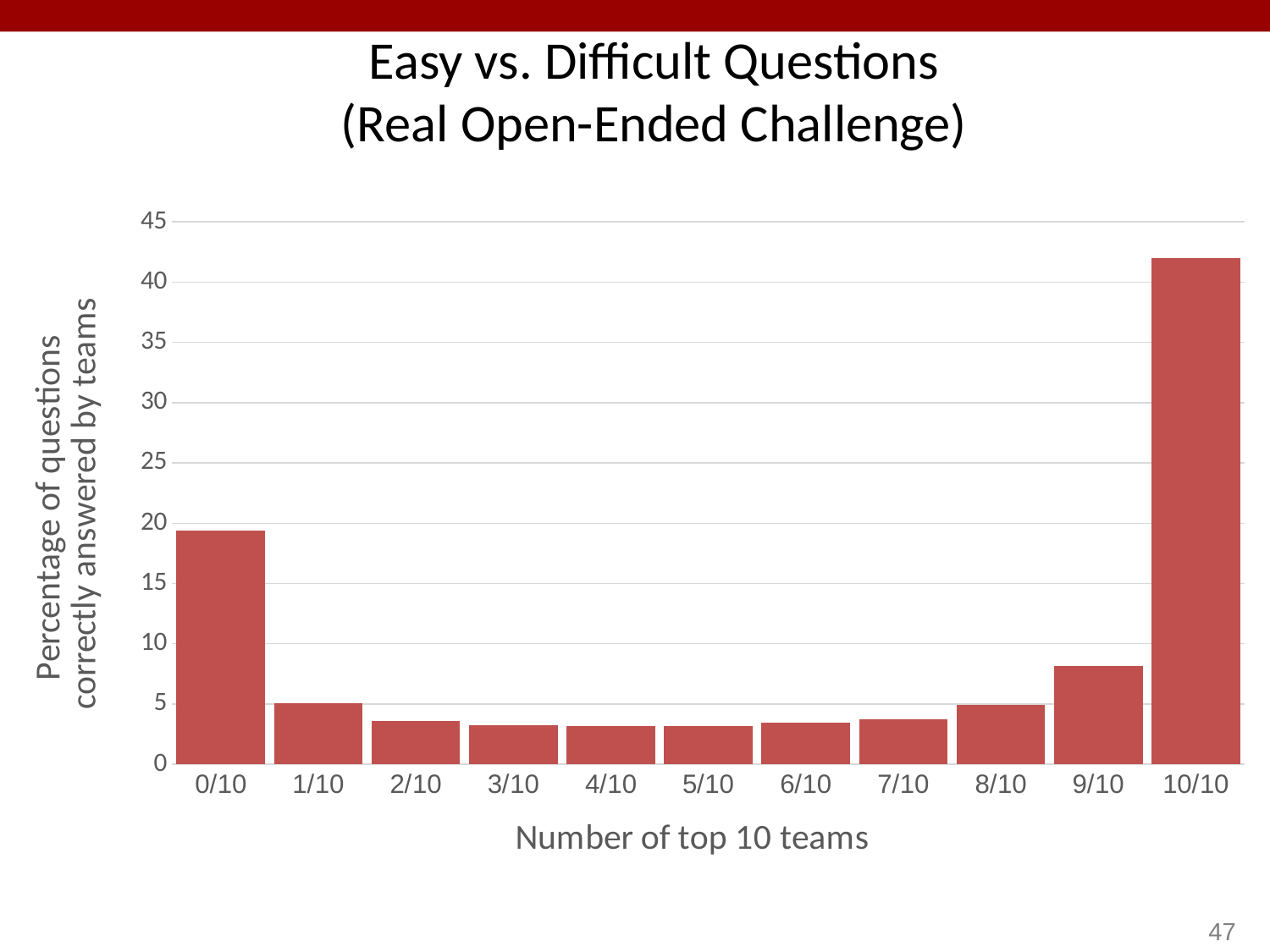
Which is larger, the value for 10/10 or the value for 0/10? 10/10 Which category has the highest percentage of questions correctly answered? 10/10 What is the title of the chart on the slide? Easy vs. Difficult Questions (Real Open-Ended Challenge) Is the value for 0/10 greater or less than 20? less Is the value for 0/10 greater or less than 15? greater Is the value for 2/10 greater or less than 5? less What kind of chart is shown on the slide? bar chart How many categories are shown on the x axis of the chart? 11 What is the label of the x axis? Number of top 10 teams Which is larger, the value for 9/10 or the value for 1/10? 9/10